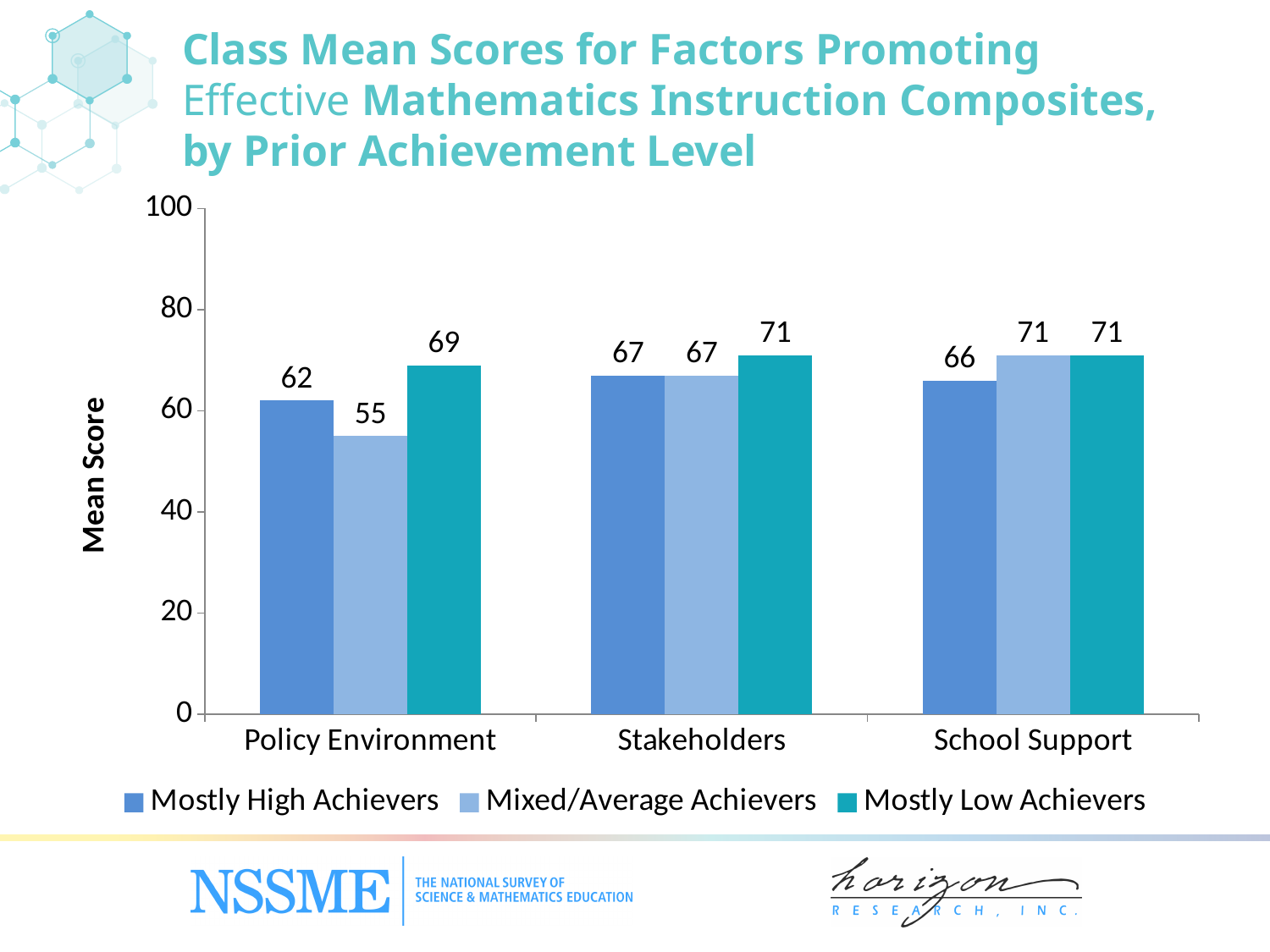
What is the label of the y axis? Mean Score What is the mean score for Mostly High Achievers in School Support? 66 How many series does the legend list? 3 What is the mean score for Mixed/Average Achievers in Policy Environment? 55 What is the difference between the Mostly Low Achievers and Mixed/Average Achievers mean scores for Policy Environment? 14 What kind of chart is shown on the slide? Bar chart Which prior achievement level has the lowest mean score for Policy Environment? Mixed/Average Achievers Which is larger: the Mostly High Achievers mean score for Policy Environment or for Stakeholders? Stakeholders What is the mean score for Mostly Low Achievers in Stakeholders? 71 How many categories are shown on the x axis? 3 What is the difference between the Mostly Low Achievers and Mostly High Achievers mean scores for School Support? 5 Which prior achievement level has the highest mean score for Policy Environment? Mostly Low Achievers